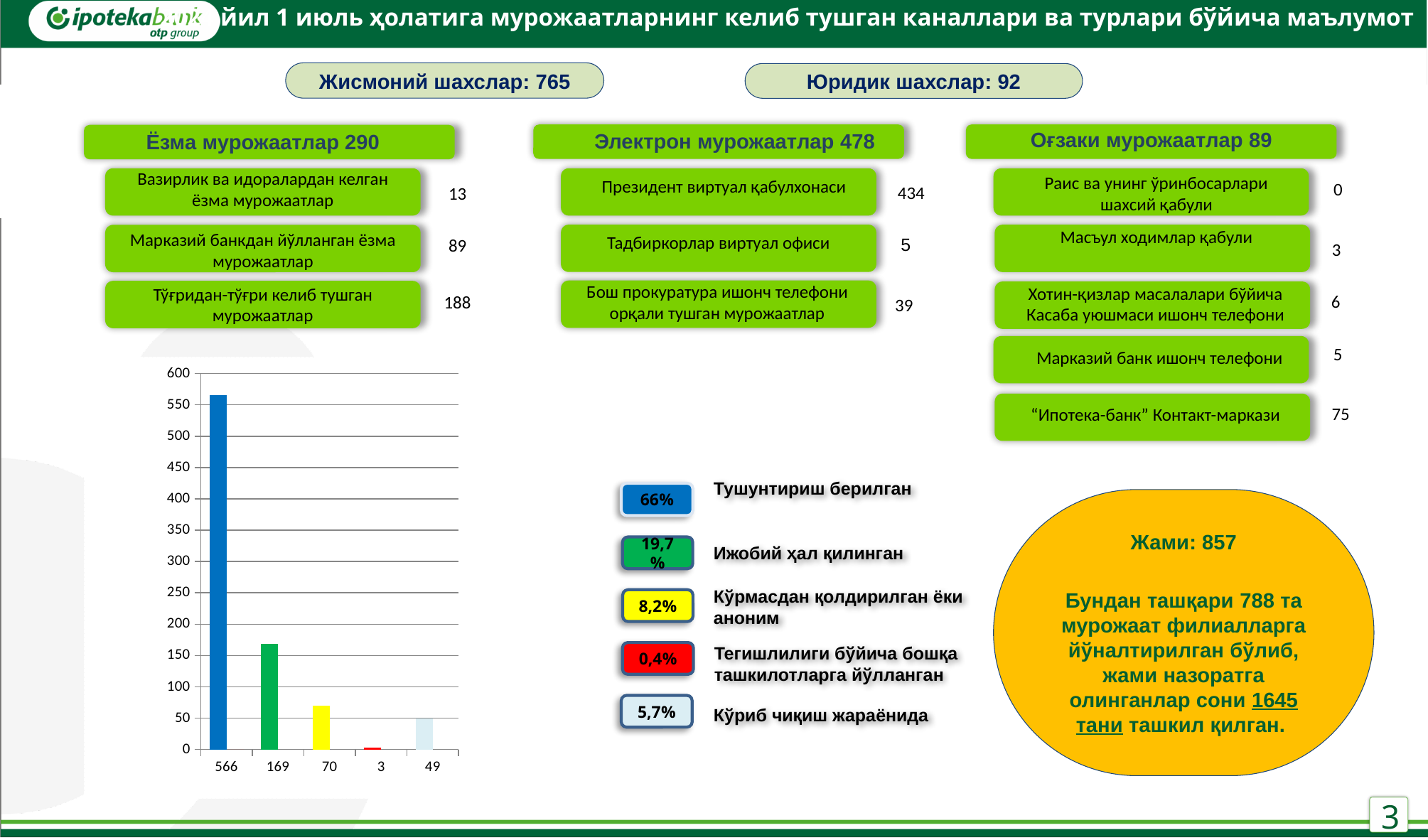
What is the value of the red bar in the chart? 3 What is the value of the first (blue) bar in the chart? 566 Which bar has the highest value in the chart? the first (blue) bar, 566 What is the total of all five bars in the chart? 857 Which is larger, the yellow bar or the light blue bar? the yellow bar (70) Which bar has the lowest value in the chart? the red bar, 3 What is the difference between the first bar (566) and the second bar (169)? 397 What is the value of the last (light blue) bar in the chart? 49 Is the value of the green bar greater or less than 150? greater What is the value of the second (green) bar in the chart? 169 How many bars does the chart contain? 5 What kind of chart is shown on the slide? bar chart